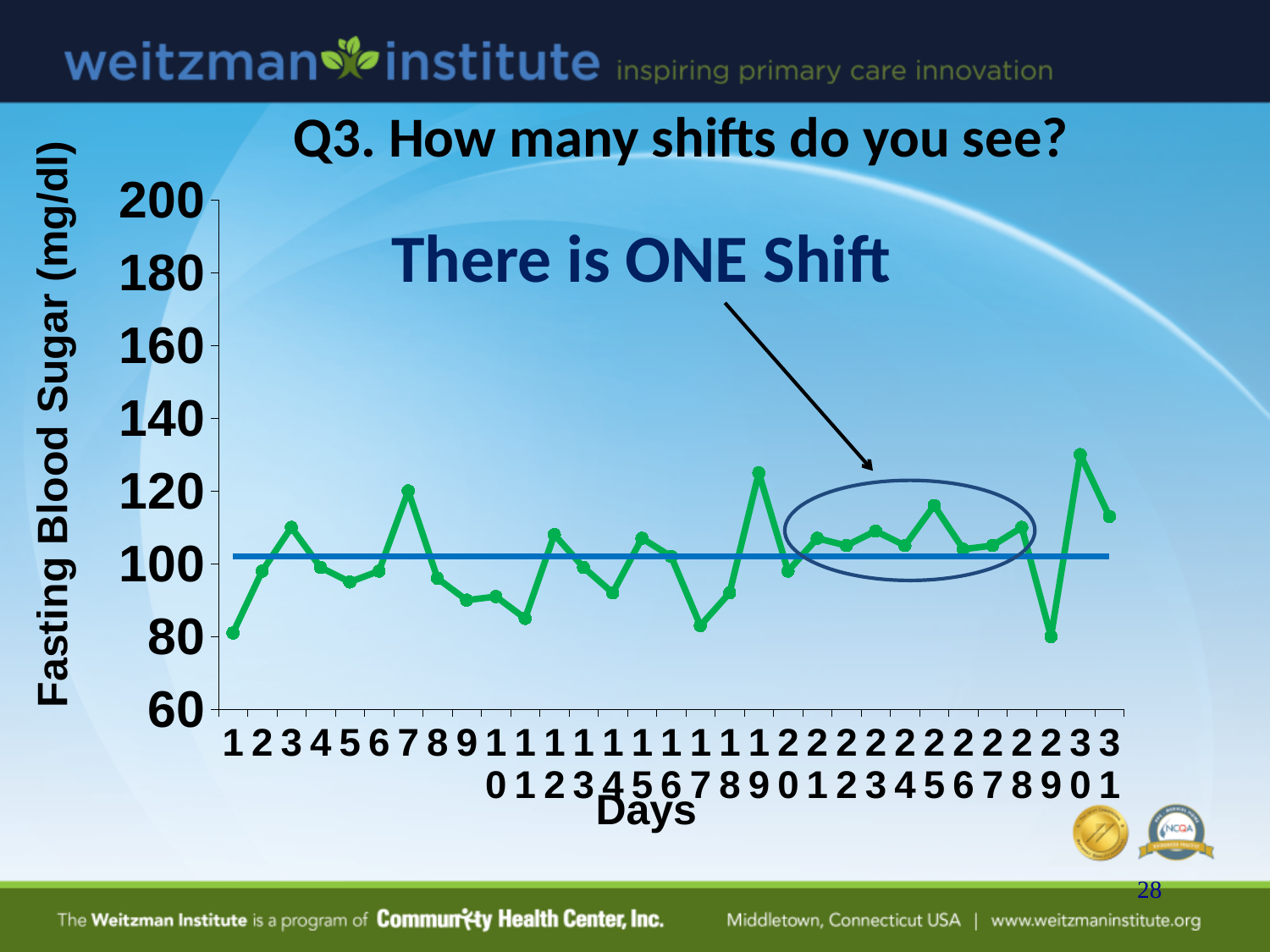
Is the fasting blood sugar value for day 1 greater or less than 100? less What is the label of the y axis? Fasting Blood Sugar (mg/dl) What kind of chart is shown on the slide? line chart Is the fasting blood sugar value for day 17 greater or less than 100? less Is the fasting blood sugar value for day 29 greater or less than 100? less Which has the higher fasting blood sugar value, day 30 or day 29? day 30 How many days are plotted along the x axis? 31 Which has the higher fasting blood sugar value, day 7 or day 1? day 7 According to the annotation on the chart, how many shifts are there? ONE